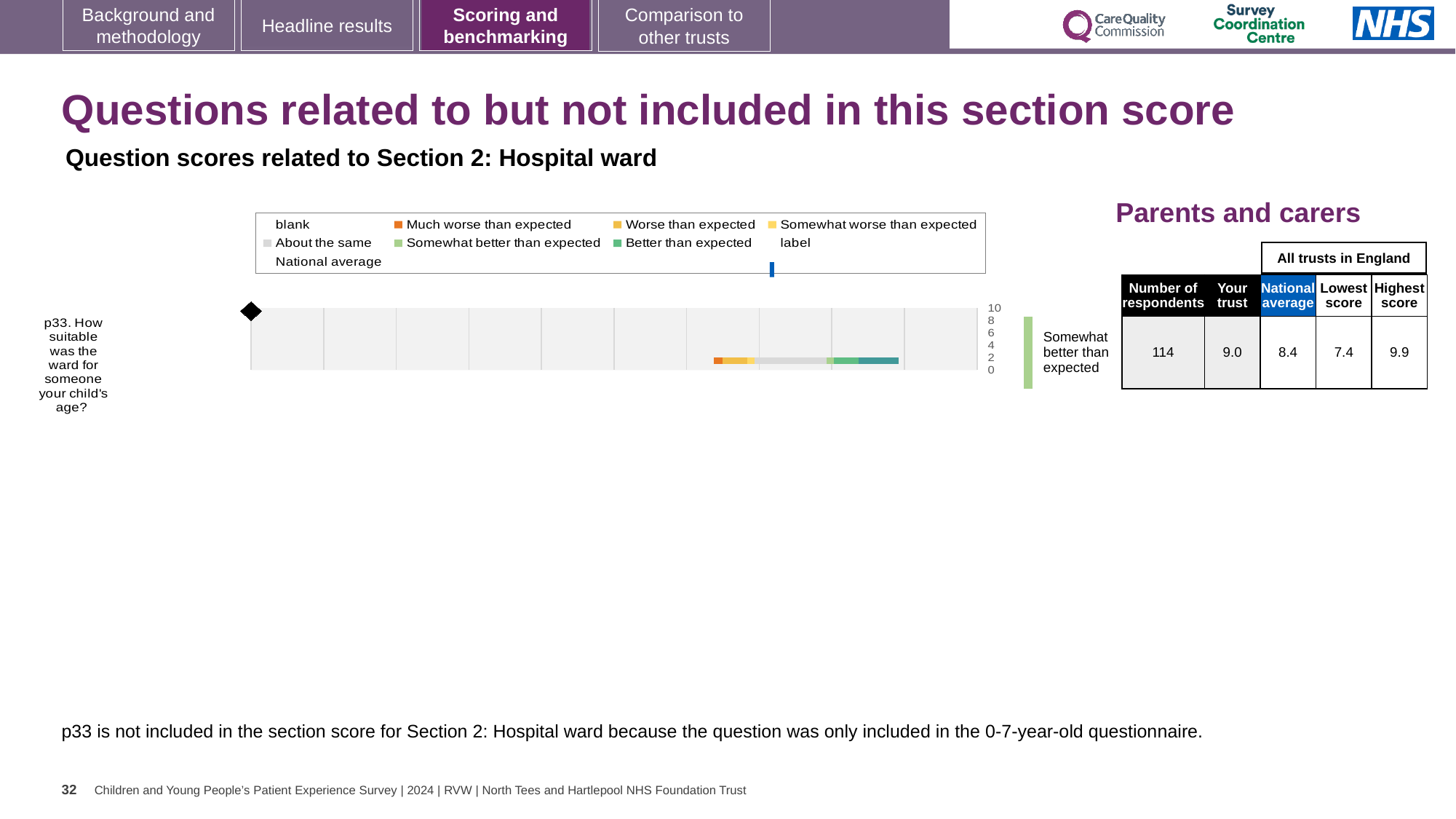
What kind of chart is shown for question p33? bar chart For p33, what is the difference between the highest score and the lowest score among all trusts in England? 2.5 In the table beside the chart, what is the highest score among all trusts in England for p33? 9.9 What rating label is shown to the right of the p33 bar? Somewhat better than expected In the table beside the chart, what is the 'Your trust' score for p33? 9.0 What is the highest value shown on the chart's score axis? 10 How many respondents answered p33 according to the table beside the chart? 114 Which question is plotted in the chart? p33. How suitable was the ward for someone your child's age? How many questions (categories) are plotted in the chart? 1 In the table beside the chart, what is the national average score for p33? 8.4 For p33, which is larger: the 'Your trust' score or the national average? Your trust In the table beside the chart, what is the lowest score among all trusts in England for p33? 7.4